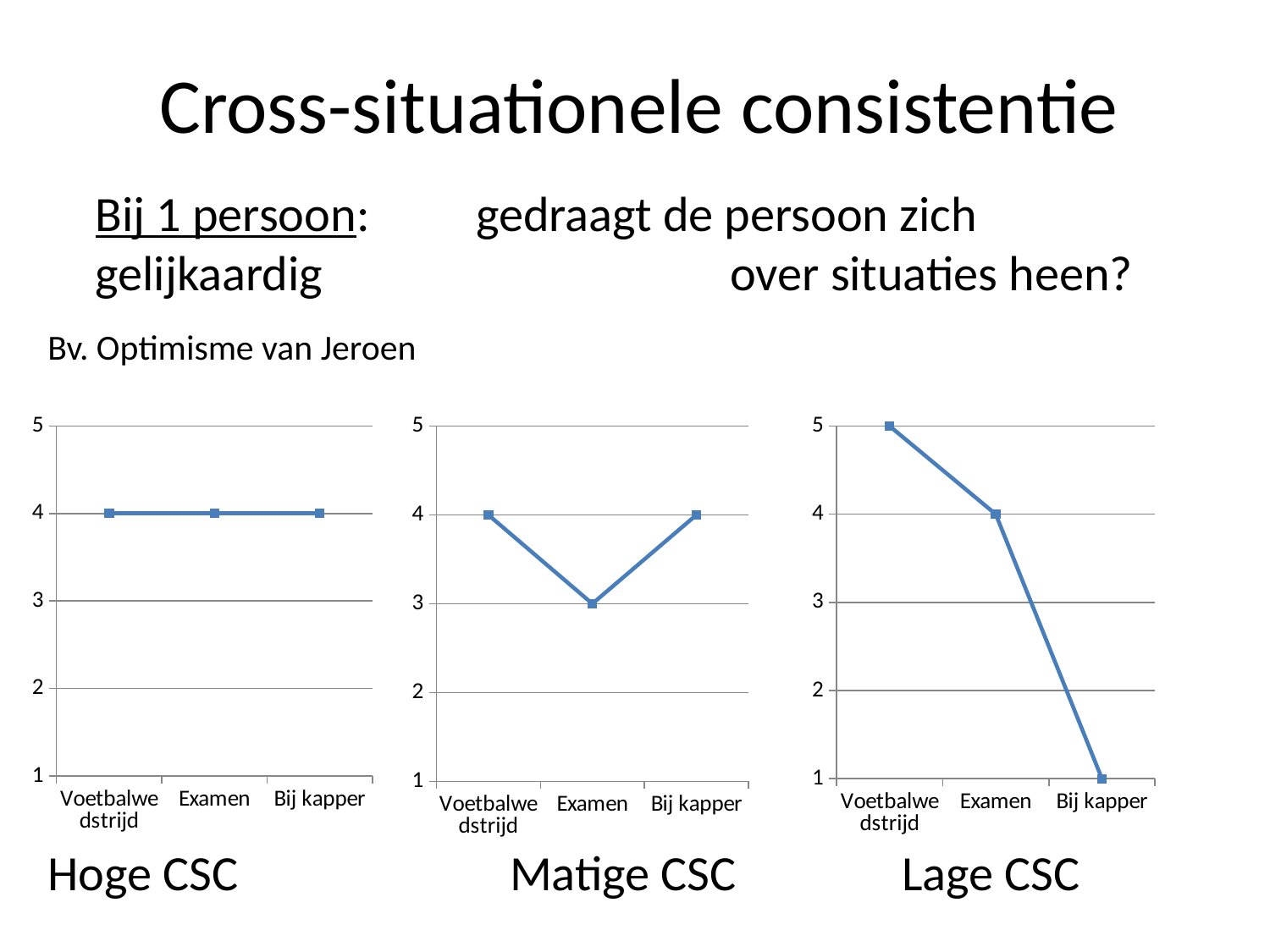
How many categories are shown on the x axis of the left chart (Hoge CSC)? 3 In the right chart (Lage CSC), what is the difference between the values for Voetbalwedstrijd and Bij kapper? 4 In the middle chart (Matige CSC), which is larger, the value for Voetbalwedstrijd or the value for Examen? Voetbalwedstrijd In the middle chart (Matige CSC), what is the value for Examen? 3 In the left chart (Hoge CSC), what is the value for Examen? 4 In the right chart (Lage CSC), what is the value for Voetbalwedstrijd? 5 In the middle chart (Matige CSC), which category has the lowest value? Examen How many charts are shown on the slide? 3 In the right chart (Lage CSC), what is the value for Bij kapper? 1 In the right chart (Lage CSC), do the values rise or fall from left to right along the x axis? Fall What kind of chart is the right chart (Lage CSC)? Line chart In the right chart (Lage CSC), which category has the highest value? Voetbalwedstrijd